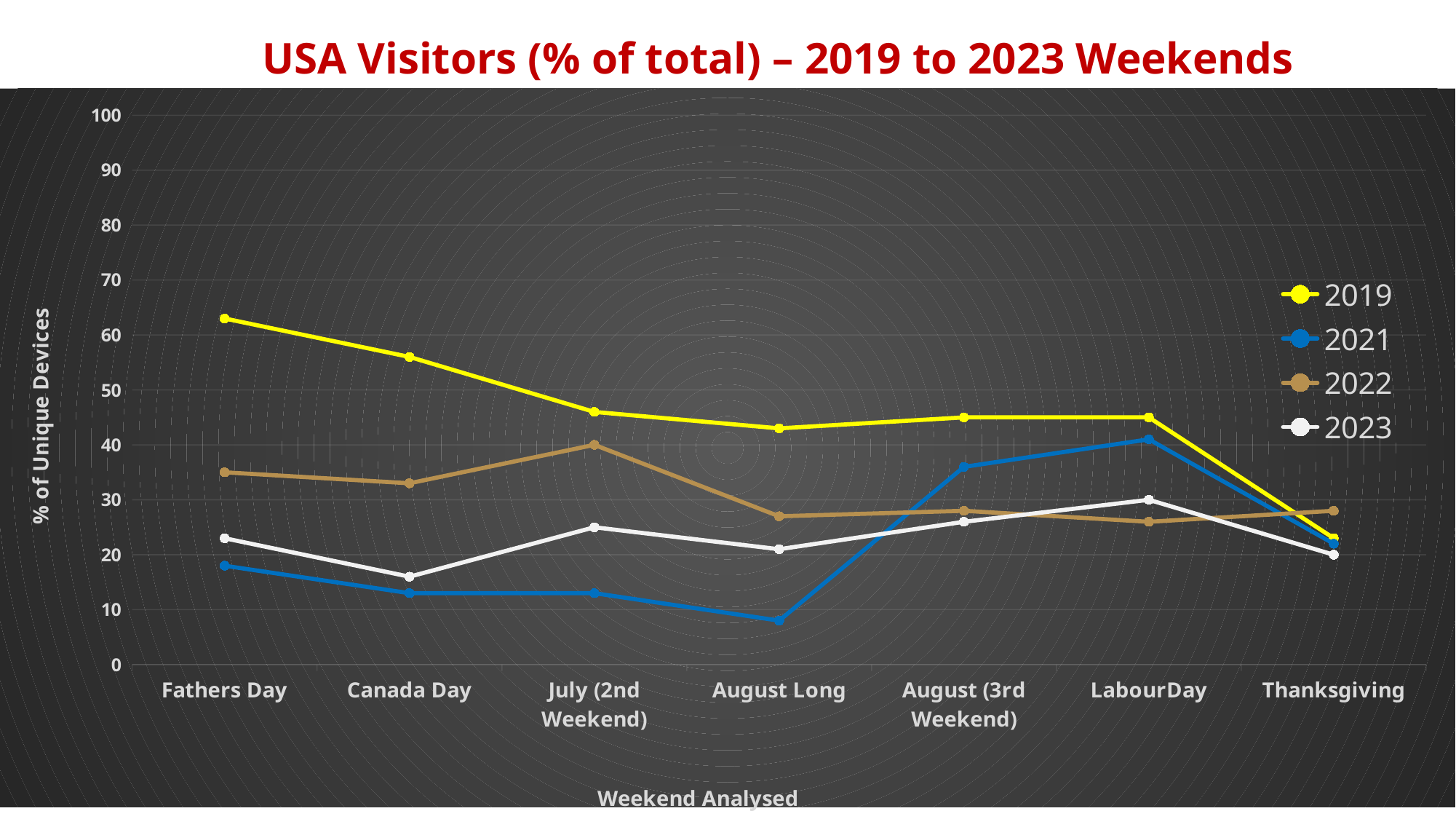
Which is larger at Canada Day, the 2022 value or the 2023 value? 2022 Is the value for 2021 at August Long greater or less than 10? less Is the value for 2019 at Fathers Day greater or less than 60? greater For the 2021 series, which weekend has the lowest value? August Long Which series has the highest value at Fathers Day? 2019 What kind of chart is shown on the slide? line chart For the 2019 series, which weekend has the highest value? Fathers Day Does the 2019 series rise or fall from Fathers Day to July (2nd Weekend)? fall How many series does the legend list? 4 How many weekends are plotted along the x axis? 7 Which series has the lowest value at August Long? 2021 What is the title of the chart? USA Visitors (% of total) – 2019 to 2023 Weekends